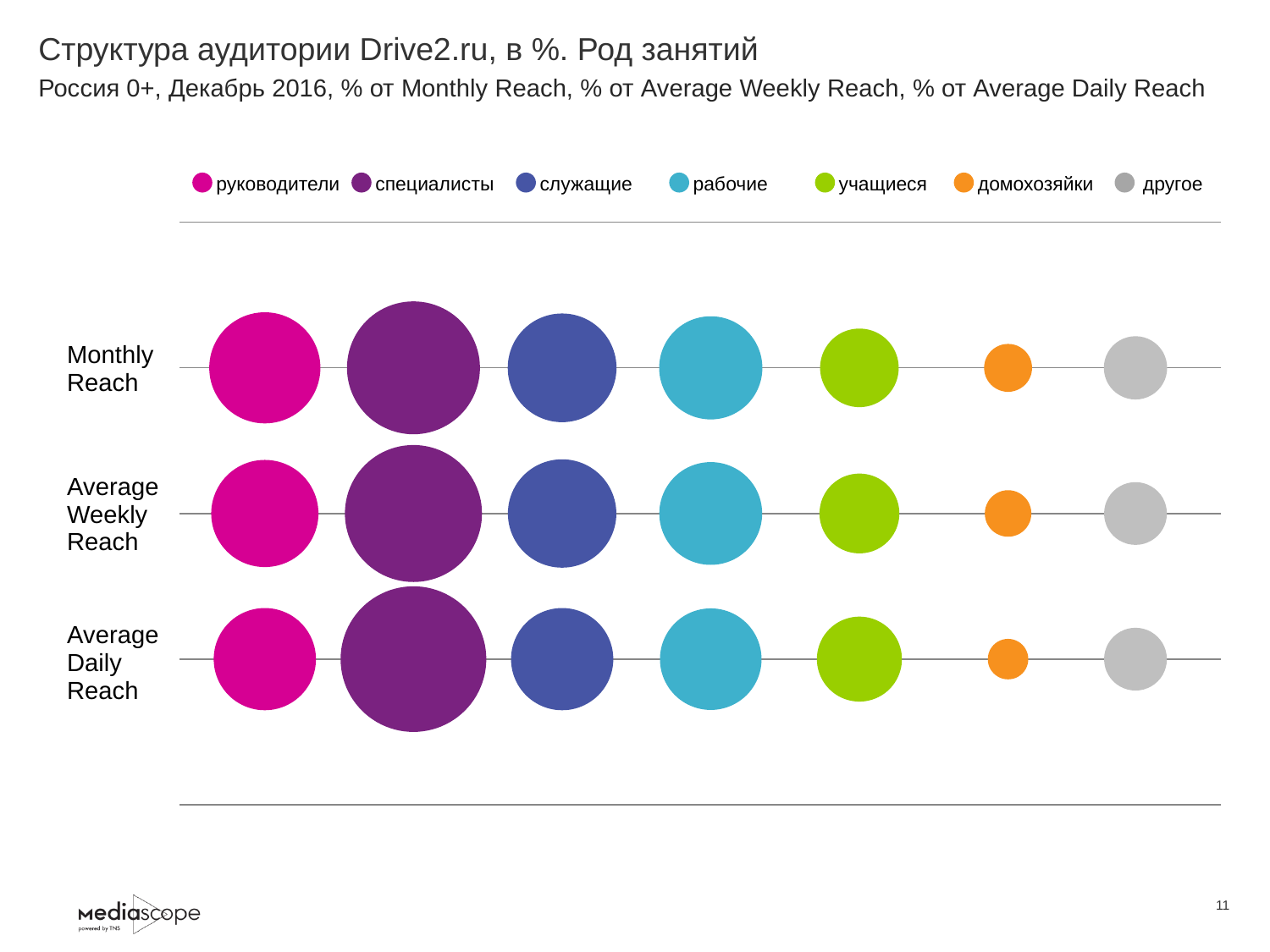
In the Average Daily Reach row, which bubble is larger: руководители or учащиеся? руководители How many occupation groups does the legend list? 7 In the Average Weekly Reach row, which bubble is larger: домохозяйки or рабочие? рабочие Which occupation group has the smallest bubble in the Average Weekly Reach row? домохозяйки Which occupation group has the smallest bubble in the Monthly Reach row? домохозяйки Which occupation group has the largest bubble in the Monthly Reach row? специалисты What is the title of the chart on the slide? Структура аудитории Drive2.ru, в %. Род занятий Which colour represents the group 'рабочие' in the legend? light blue How many reach rows (categories) are plotted on the chart? 3 In the Monthly Reach row, which bubble is larger: специалисты or другое? специалисты Which occupation group has the largest bubble in the Average Daily Reach row? специалисты What kind of chart is shown on the slide? bubble chart